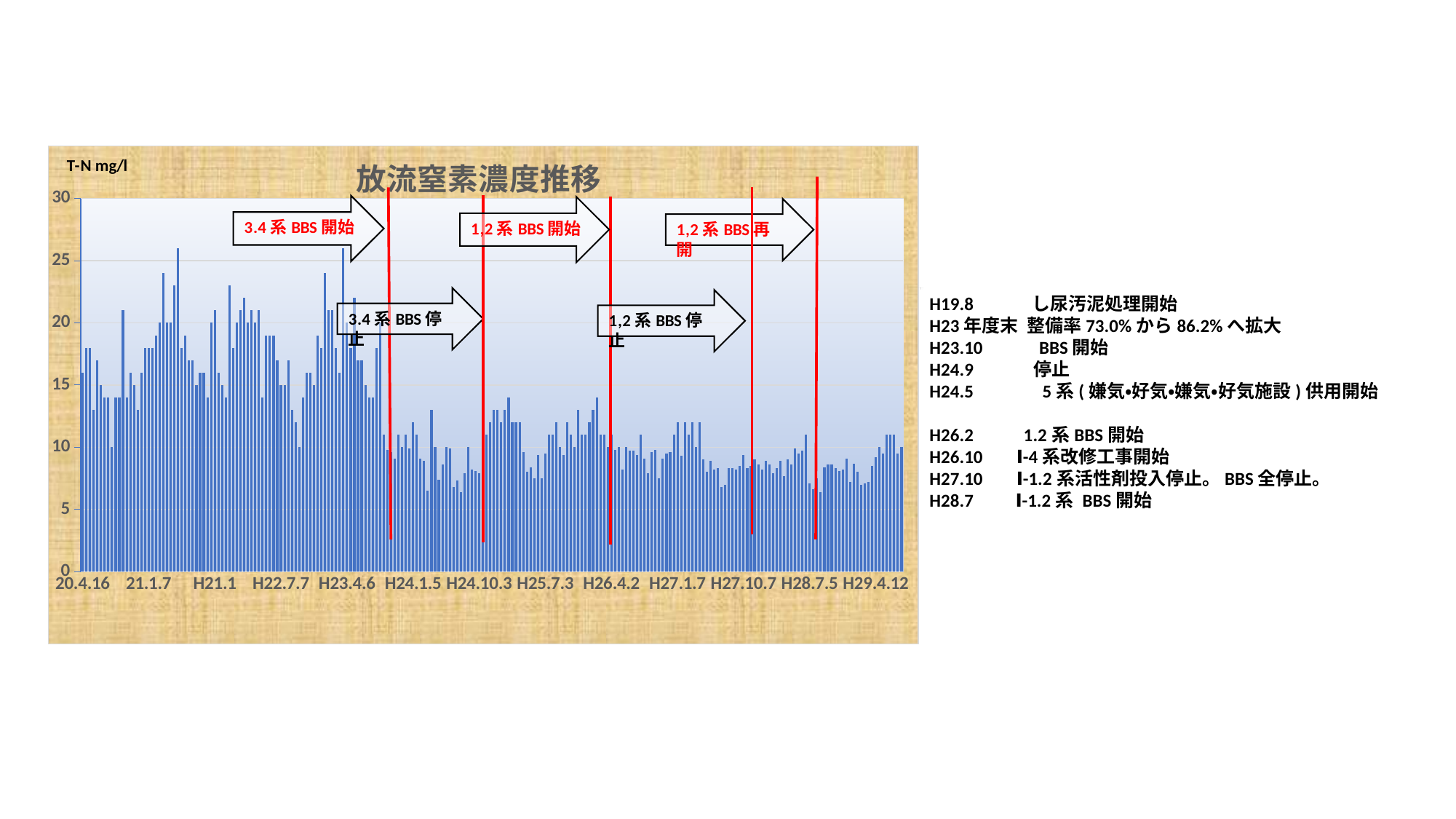
What is the first label on the horizontal axis? 20.4.16 Is the value of the tallest bar in the chart greater or less than 25? greater Do the bar values generally rise or fall from left to right along the x axis? fall Is the value of the bar at H29.4.12 greater or less than 15? less Are the bars around H21.1 generally higher or lower than the bars around H27.1.7? higher What is the last label on the horizontal axis? H29.4.12 What unit label is shown on the vertical axis of the chart? T-N mg/l What is the highest value shown on the vertical axis? 30 What is the title of the chart? 放流窒素濃度推移 How many labels are printed along the horizontal axis? 13 How many red vertical lines mark events on the chart? 4 What kind of chart is shown on the slide? bar chart